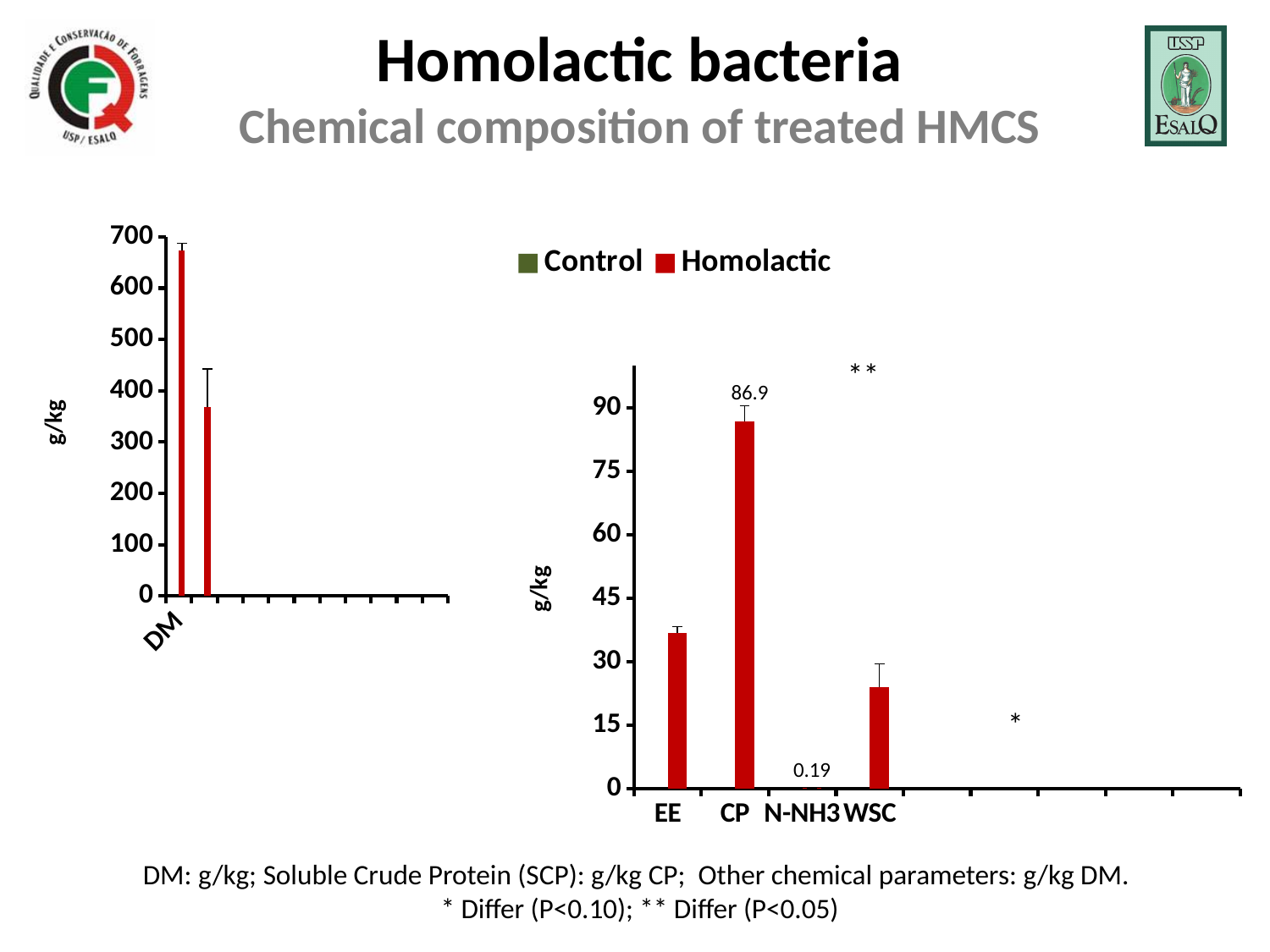
What kind of chart is the right chart? Bar chart How many series does the legend list? 2 On the right chart, what is the value printed for N-NH3? 0.19 On the right chart, which is larger, the bar for EE or the bar for WSC? EE On the left chart, is the first DM bar greater or less than 600? greater On the right chart, which category has the highest bar? CP How many labelled categories are shown on the x axis of the right chart? 4 On the left chart, is the second DM bar greater or less than 500? less On the right chart, what is the value printed for CP? 86.9 On the right chart, which category has the lowest value? N-NH3 On the right chart, what is the difference between the CP value and the N-NH3 value? 86.71 On the right chart, is the value for EE greater or less than 30? greater